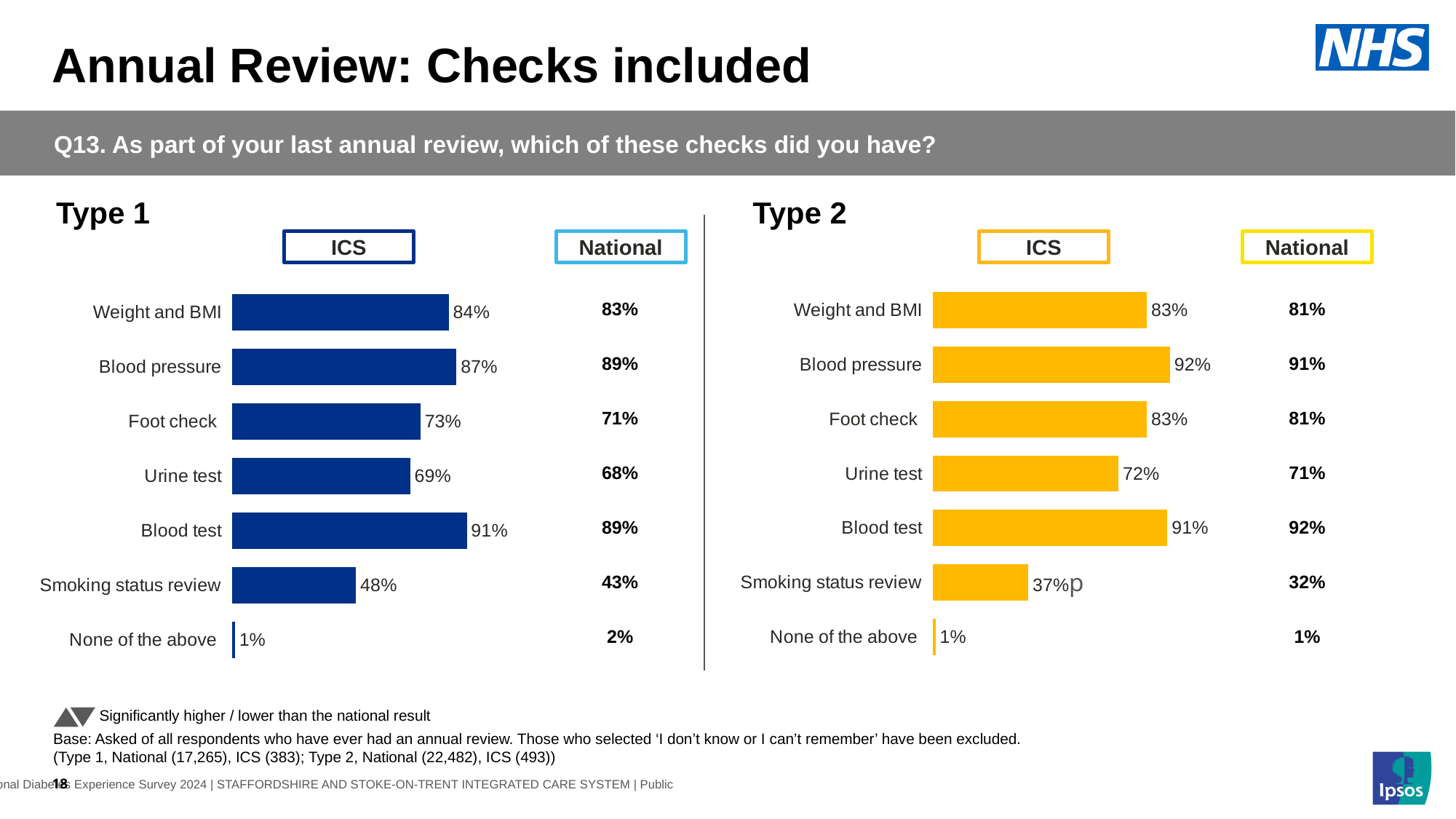
In the Type 1 chart, which category has the lowest ICS value? None of the above In the Type 1 chart, what is the difference between the ICS and National values for Smoking status review? 5 percentage points In the Type 2 chart, what is the ICS value for Smoking status review? 37% In the Type 2 chart, which check has the highest ICS value? Blood pressure In the Type 1 chart, what is the ICS value for Blood pressure? 87% In the Type 1 chart, what is the National value for Foot check? 71% In the Type 1 chart, which check has the highest ICS value? Blood test What colour are the bars in the Type 2 chart? yellow How many categories are shown in the Type 1 chart? 7 In the Type 2 chart, is the ICS value for Weight and BMI larger or smaller than the National value? larger What type of chart is used for the Type 2 ICS results? bar chart In the Type 2 chart, what is the difference between the ICS values for Blood pressure and Urine test? 20 percentage points